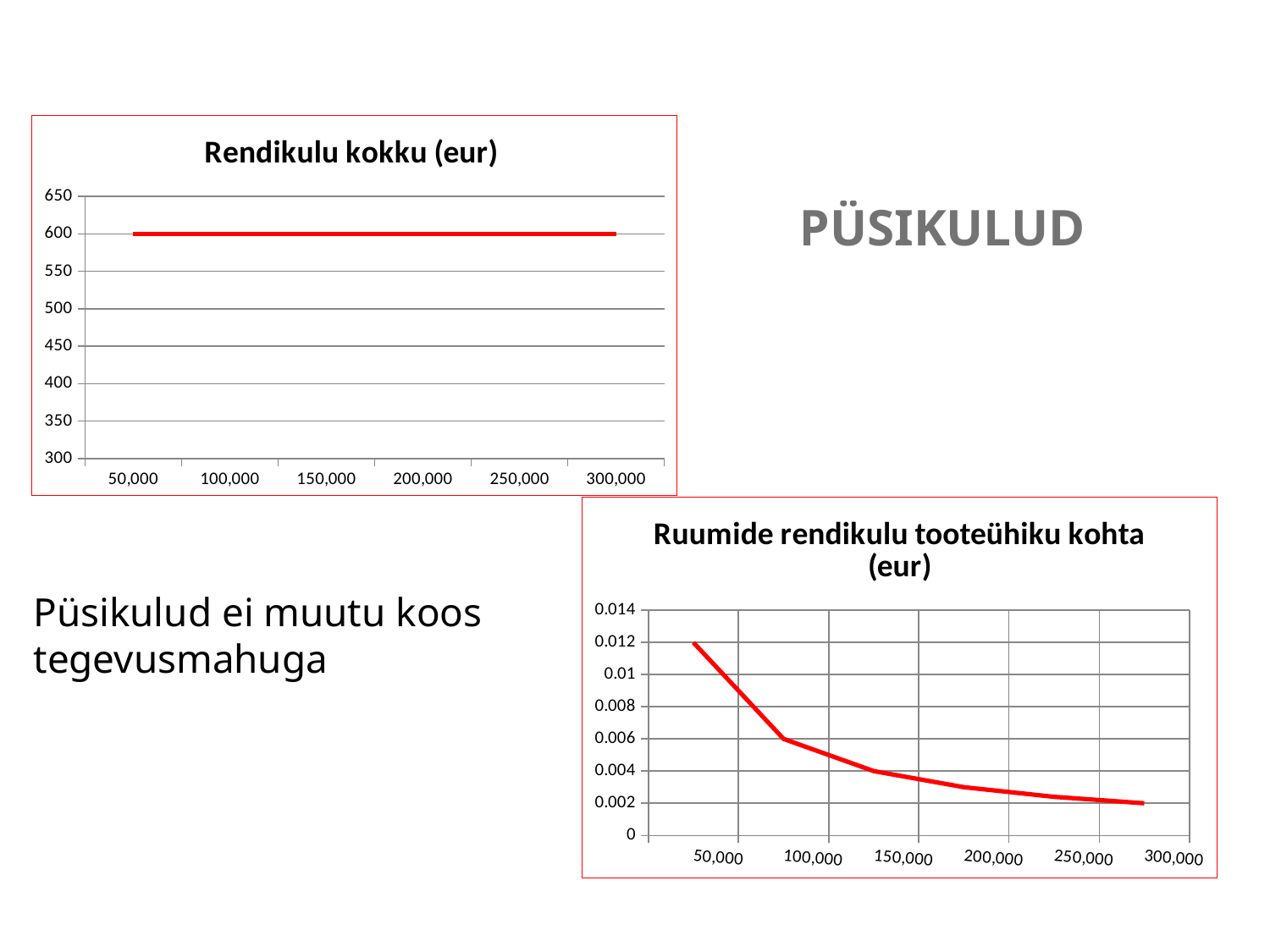
In the 'Ruumide rendikulu tooteühiku kohta (eur)' chart, do the values rise or fall as the x axis increases? fall In the 'Rendikulu kokku (eur)' chart, do the values rise, fall or stay flat as the x axis increases? stay flat In the 'Ruumide rendikulu tooteühiku kohta (eur)' chart, what is the value at 50,000? 0.012 In the 'Ruumide rendikulu tooteühiku kohta (eur)' chart, what is the value at 300,000? 0.002 In the 'Rendikulu kokku (eur)' chart, what is the value at 300,000? 600 What kind of chart is the 'Rendikulu kokku (eur)' chart? line chart What kind of chart is the 'Ruumide rendikulu tooteühiku kohta (eur)' chart? line chart In the 'Ruumide rendikulu tooteühiku kohta (eur)' chart, what is the value at 100,000? 0.006 In the 'Ruumide rendikulu tooteühiku kohta (eur)' chart, is the value at 200,000 greater or less than 0.004? less In the 'Ruumide rendikulu tooteühiku kohta (eur)' chart, at which x-axis value is the cost per unit highest? 50,000 How many x-axis tick labels are shown on the 'Rendikulu kokku (eur)' chart? 6 In the 'Rendikulu kokku (eur)' chart, what is the value at 50,000? 600